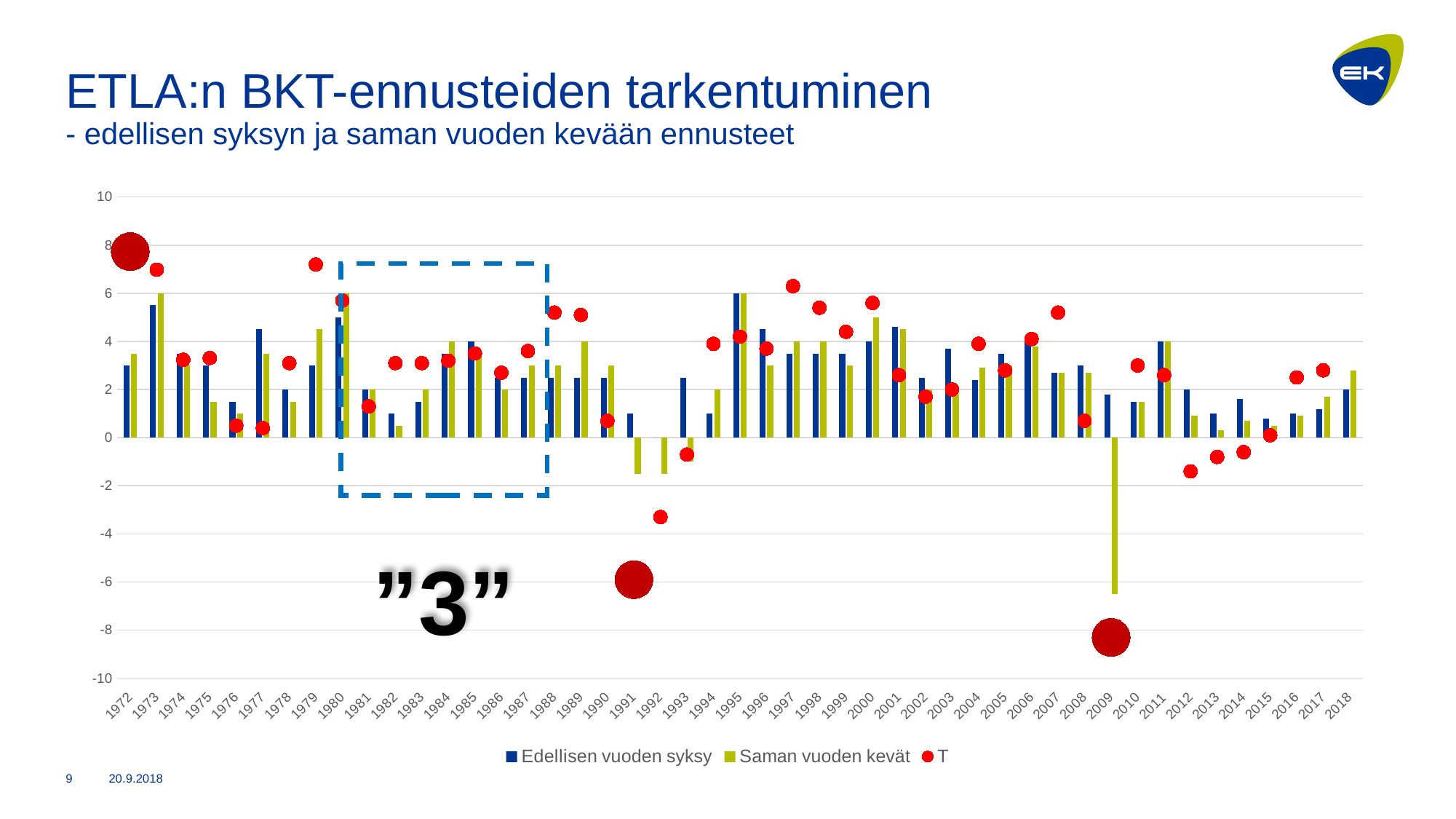
Which year has the lowest Saman vuoden kevät value? 2009 Which is larger, the Edellisen vuoden syksy value for 1973 or for 1976? 1973 Is the Saman vuoden kevät value for 2012 greater or less than 2? less What are the first and last years shown on the x axis? 1972 and 2018 Is the Saman vuoden kevät value for 2009 greater or less than -6? less How many years are shown on the x axis? 47 Which year has the lowest T value? 2009 How many series does the legend list? 3 Is the Edellisen vuoden syksy value for 1995 greater or less than 4? greater What kind of chart is shown on the slide? combination bar and line chart (bars with red dot markers)